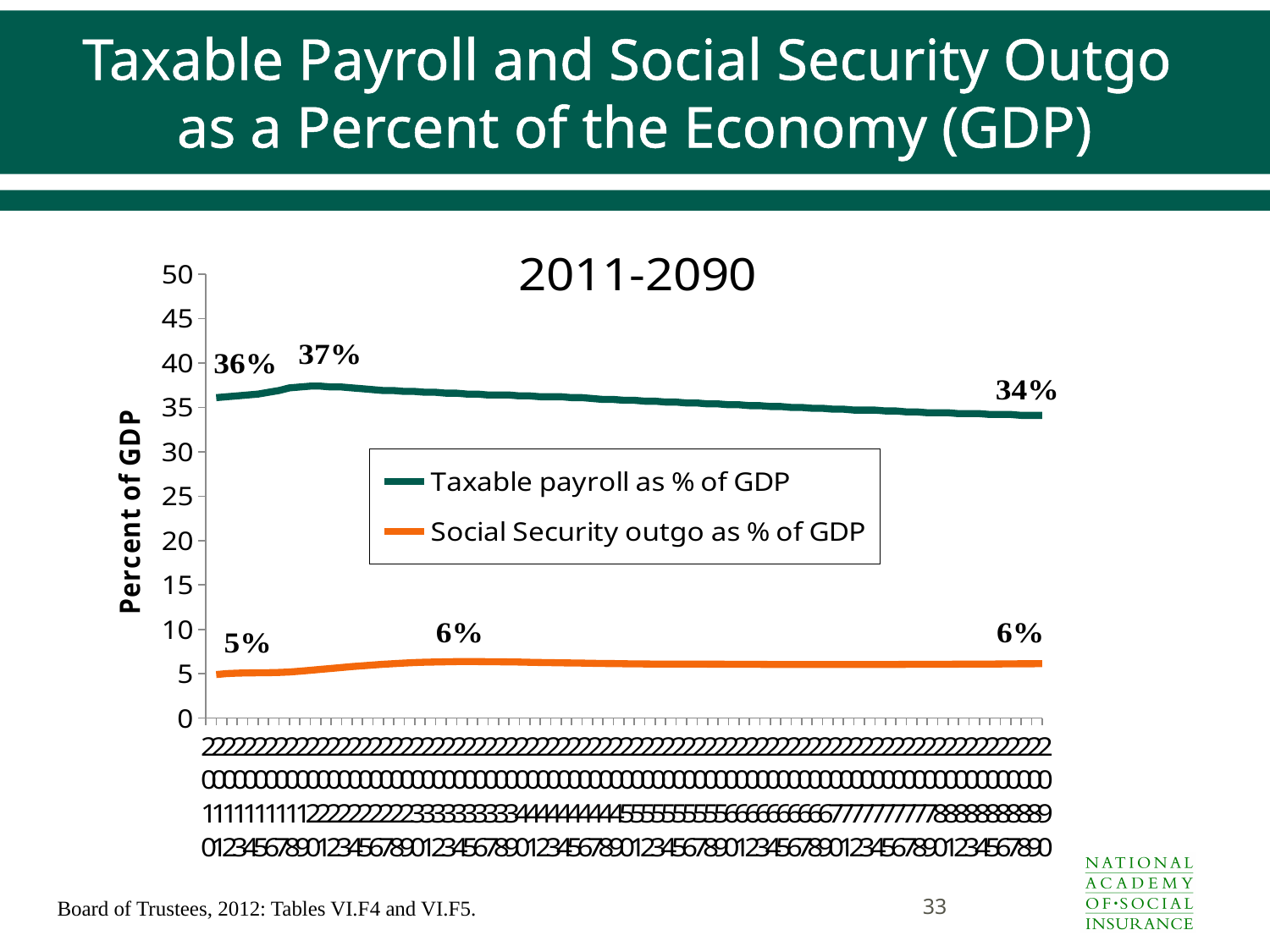
Overall, does taxable payroll as % of GDP rise or fall from 2011 to 2090? fall Is the value of Social Security outgo as % of GDP in the middle of the period greater or less than 10? less What is the labelled value of taxable payroll as % of GDP at the end of the period (2090)? 34% What is the labelled value of Social Security outgo as % of GDP at the end of the period (2090)? 6% What is the labelled value of taxable payroll as % of GDP at the start of the period (2011)? 36% What is the label on the vertical axis of the chart? Percent of GDP How many series does the legend list? 2 What is the labelled value of Social Security outgo as % of GDP at the start of the period (2011)? 5% Which series has the higher values throughout the chart, taxable payroll or Social Security outgo? Taxable payroll as % of GDP By how many percentage points does the labelled taxable payroll value fall from 2011 (36%) to 2090 (34%)? 2 percentage points What is the labelled peak value of taxable payroll as % of GDP? 37% What kind of chart is shown on the slide? line chart